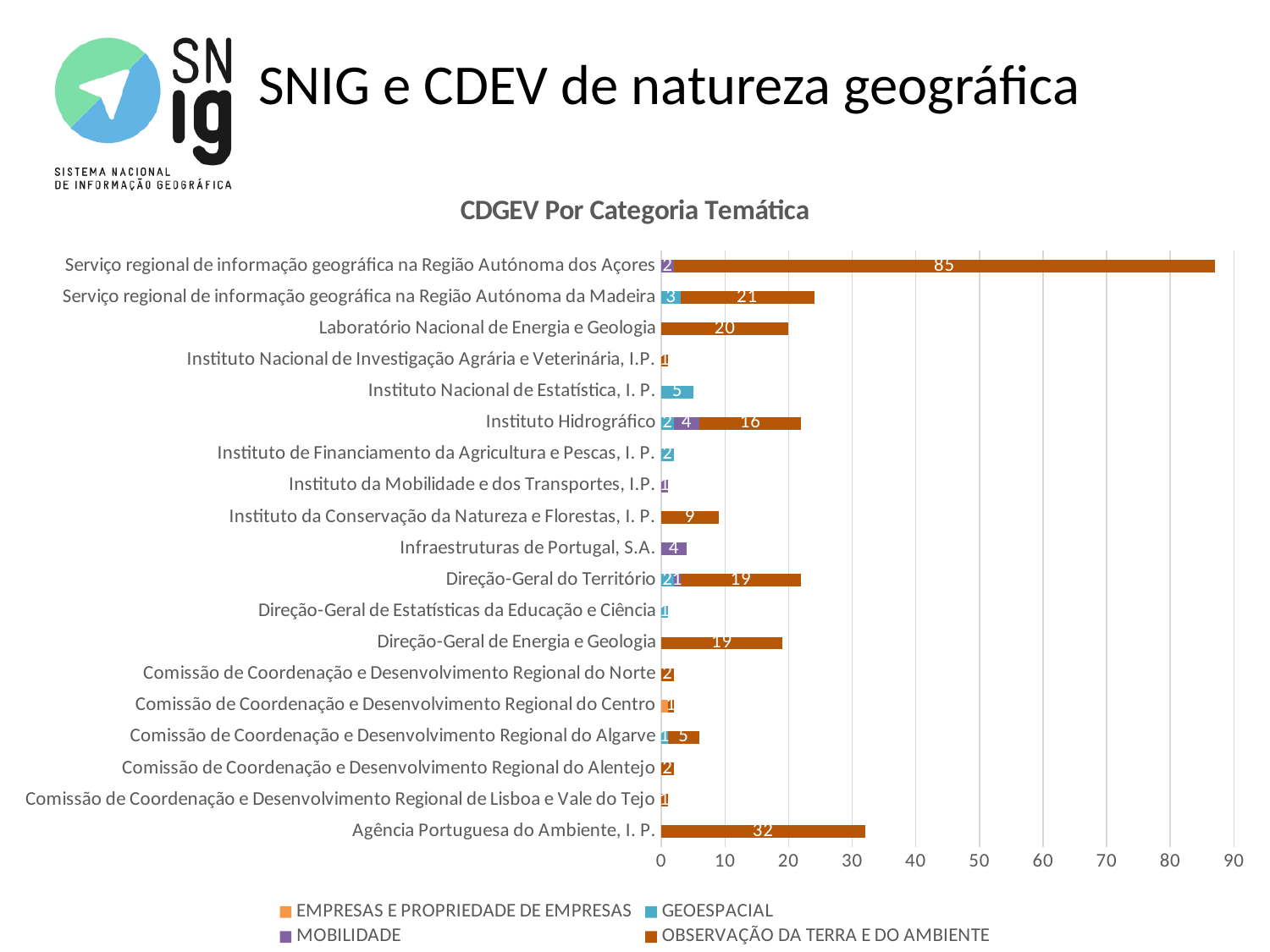
How many series does the legend list? 4 What is the value for Agência Portuguesa do Ambiente, I. P.? 32 What is the GEOESPACIAL value for Instituto Nacional de Estatística, I. P.? 5 What is the total of the stacked bar for Instituto Hidrográfico? 22 What is the total of the stacked bar for Serviço regional de informação geográfica na Região Autónoma da Madeira? 24 Which is larger, the value for Agência Portuguesa do Ambiente, I. P. or for Direção-Geral de Energia e Geologia? Agência Portuguesa do Ambiente, I. P. How many categories (organisations) are shown on the chart? 19 Which organisation has the longest bar overall? Serviço regional de informação geográfica na Região Autónoma dos Açores What is the title of the chart? CDGEV Por Categoria Temática What type of chart is shown on the slide? bar chart What is the difference between the values for Agência Portuguesa do Ambiente, I. P. and Laboratório Nacional de Energia e Geologia? 12 What is the OBSERVAÇÃO DA TERRA E DO AMBIENTE value for Serviço regional de informação geográfica na Região Autónoma dos Açores? 85